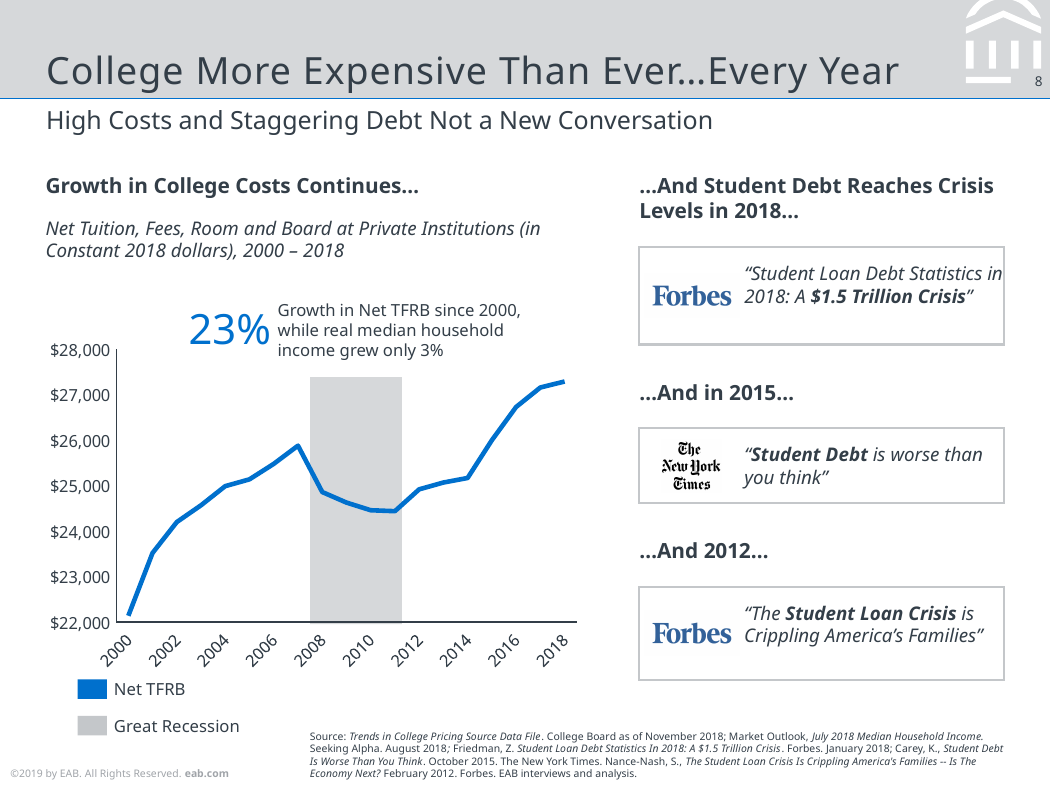
What does the grey shaded area on the chart represent? Great Recession What kind of chart is used to show Net Tuition, Fees, Room and Board at Private Institutions? Line chart Is the Net TFRB value for 2018 greater or less than $27,000? greater Overall, does Net TFRB rise or fall between 2000 and 2018? Rise Is the Net TFRB value for 2010 greater or less than $25,000? less In which year is Net TFRB lowest? 2000 According to the annotation on the chart, by what percentage has Net TFRB grown since 2000? 23% In which year is Net TFRB highest? 2018 Is the Net TFRB value for 2016 greater or less than $26,000? greater Which year has a higher Net TFRB value, 2007 or 2010? 2007 How many entries does the chart legend list? 2